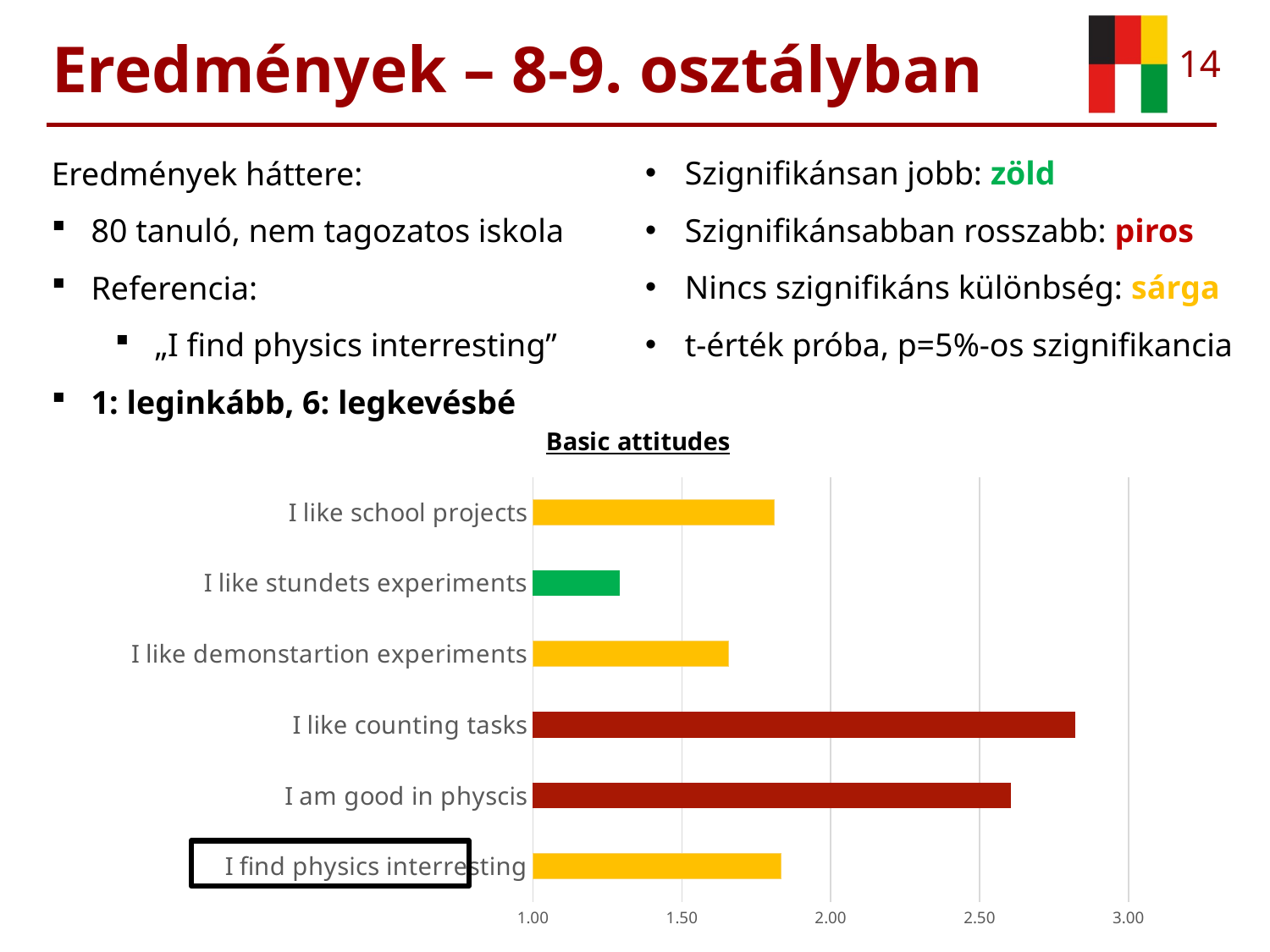
Which has the larger value: "I am good in physcis" or "I like demonstartion experiments"? I am good in physcis Is the value for "I am good in physcis" greater or less than 2.50? greater Which category has the highest value in the chart? I like counting tasks How many categories are plotted in the chart? 6 Is the value for "I find physics interresting" greater or less than 2.00? less Is the value for "I like demonstartion experiments" greater or less than 1.50? greater What is the title of the chart? Basic attitudes What colour is the bar for "I like stundets experiments"? green Which category has the lowest value in the chart? I like stundets experiments What kind of chart is shown on the slide? bar chart